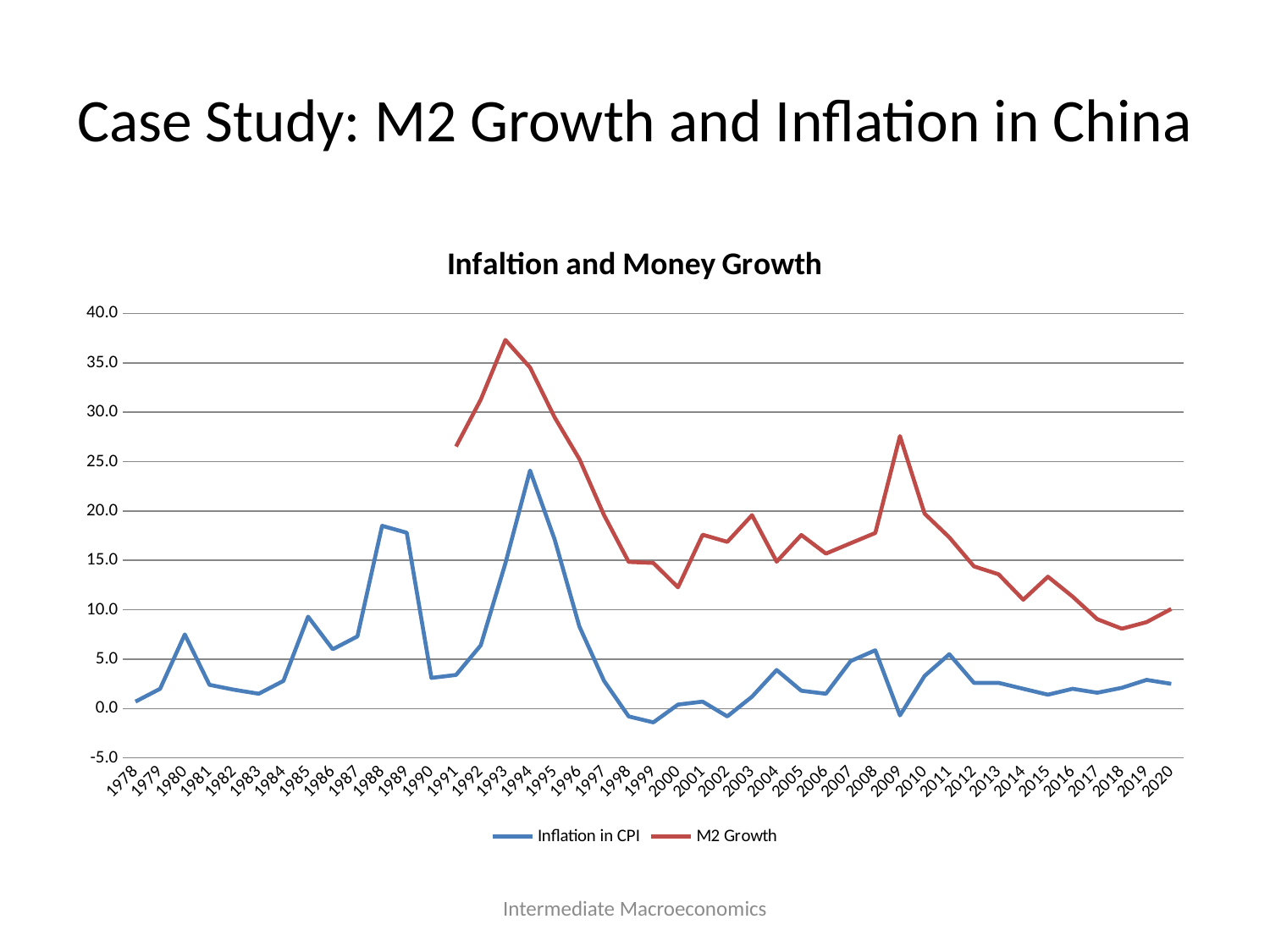
How many years are shown on the x axis? 43 In which year does M2 Growth reach its highest value? 1993 What kind of chart is shown on the slide? Line chart Is the value for M2 Growth in 2009 greater or less than 25.0? greater Does M2 Growth rise or fall from 2009 to 2018? Fall Is the value for Inflation in CPI in 1999 greater or less than 0.0? less Is the value for M2 Growth in 1993 greater or less than 35.0? greater Which is larger: M2 Growth in 1993 or Inflation in CPI in 1994? M2 Growth in 1993 How many series does the legend list? 2 What is the title of the chart? Infaltion and Money Growth In which year does Inflation in CPI reach its highest value? 1994